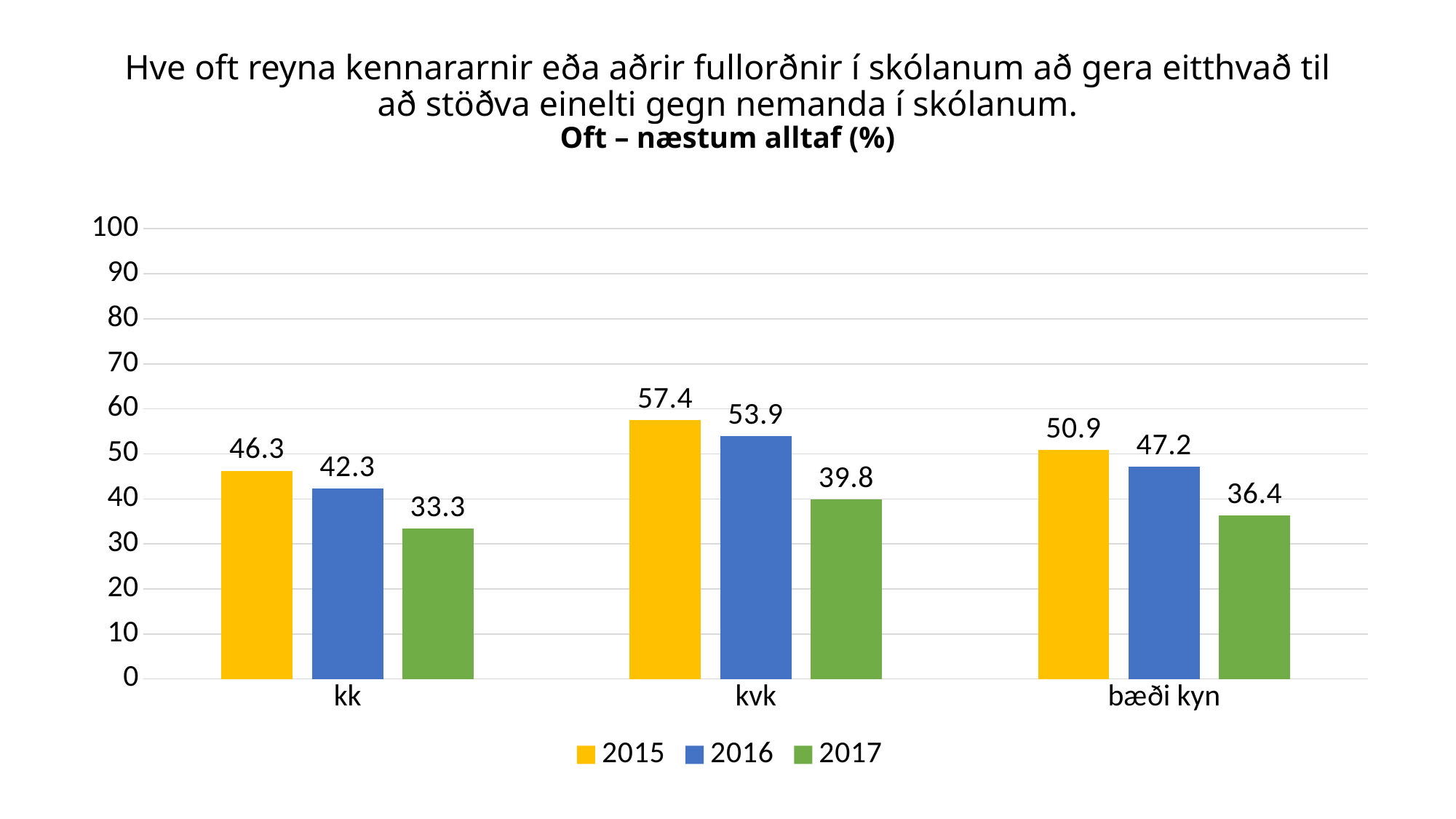
What is the difference between the 2015 and 2017 values for kvk? 17.6 What kind of chart is shown on the slide? bar chart What is the value for bæði kyn in 2016? 47.2 Which colour represents the 2017 series in the legend? green Which category has the lowest value in the 2017 series? kk How many categories are shown on the x axis? 3 Which category has the highest value in the 2016 series? kvk Is the value for kvk in 2017 greater or less than 50? less What is the value for kk in 2017? 33.3 Which is larger: the 2016 value for kk or the 2016 value for bæði kyn? bæði kyn How many series does the legend list? 3 What is the value for kvk in 2015? 57.4